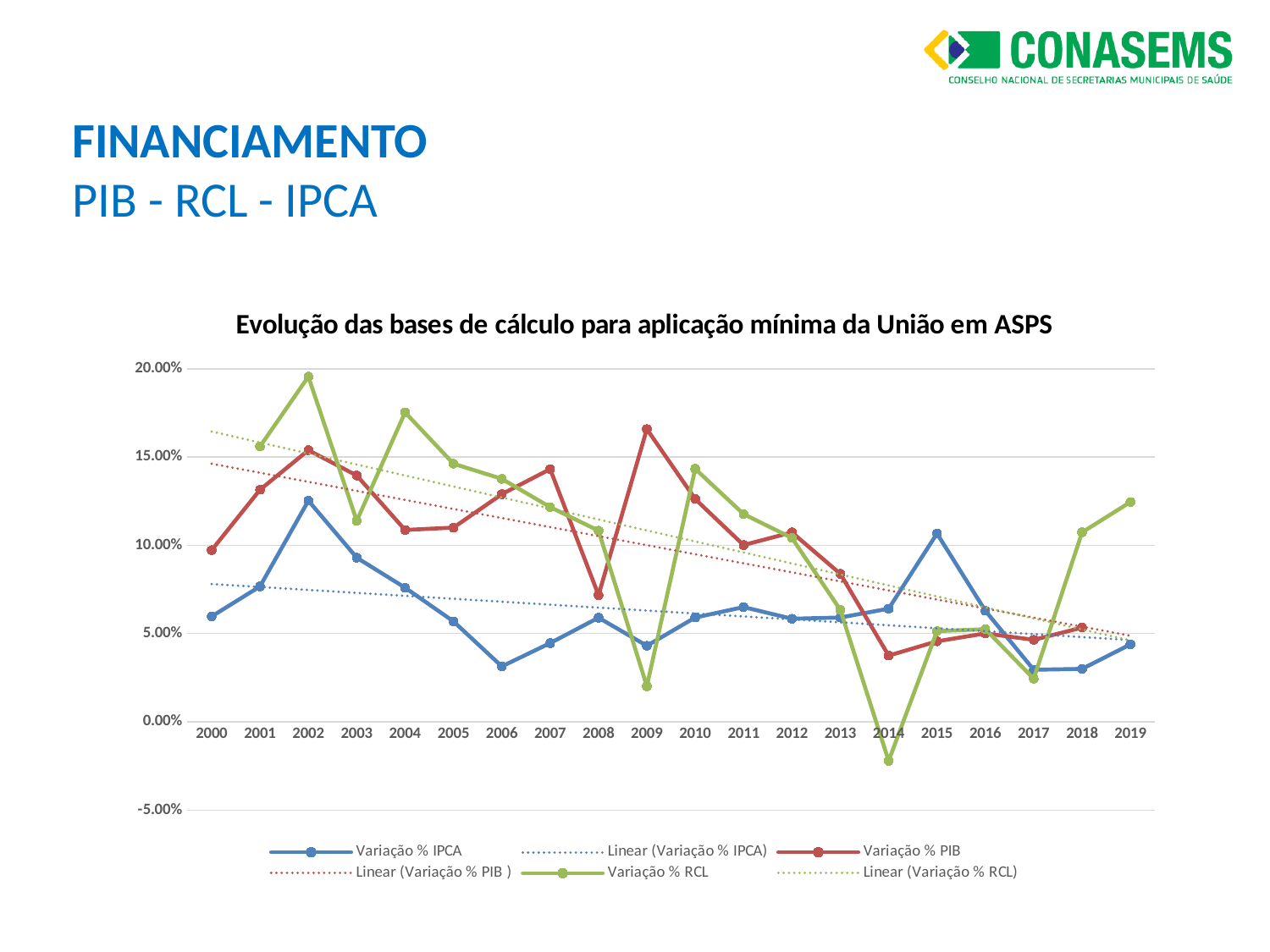
How many entries does the chart legend list? 6 Does the Linear (Variação % IPCA) trendline rise or fall from 2000 to 2019? fall What kind of chart is shown on the slide? line chart In which year does the Variação % IPCA series reach its highest value? 2002 How many years are shown along the x axis of the chart? 20 What is the title of the chart? Evolução das bases de cálculo para aplicação mínima da União em ASPS Is the value for Variação % RCL in 2014 greater or less than 0.00%? less In which year does the Variação % PIB series reach its highest value? 2009 In which year does the Variação % RCL series reach its highest value? 2002 In which year does the Variação % RCL series reach its lowest value? 2014 Is the value for Variação % RCL in 2002 greater or less than 15.00%? greater In 2009, which is larger: Variação % PIB or Variação % IPCA? Variação % PIB